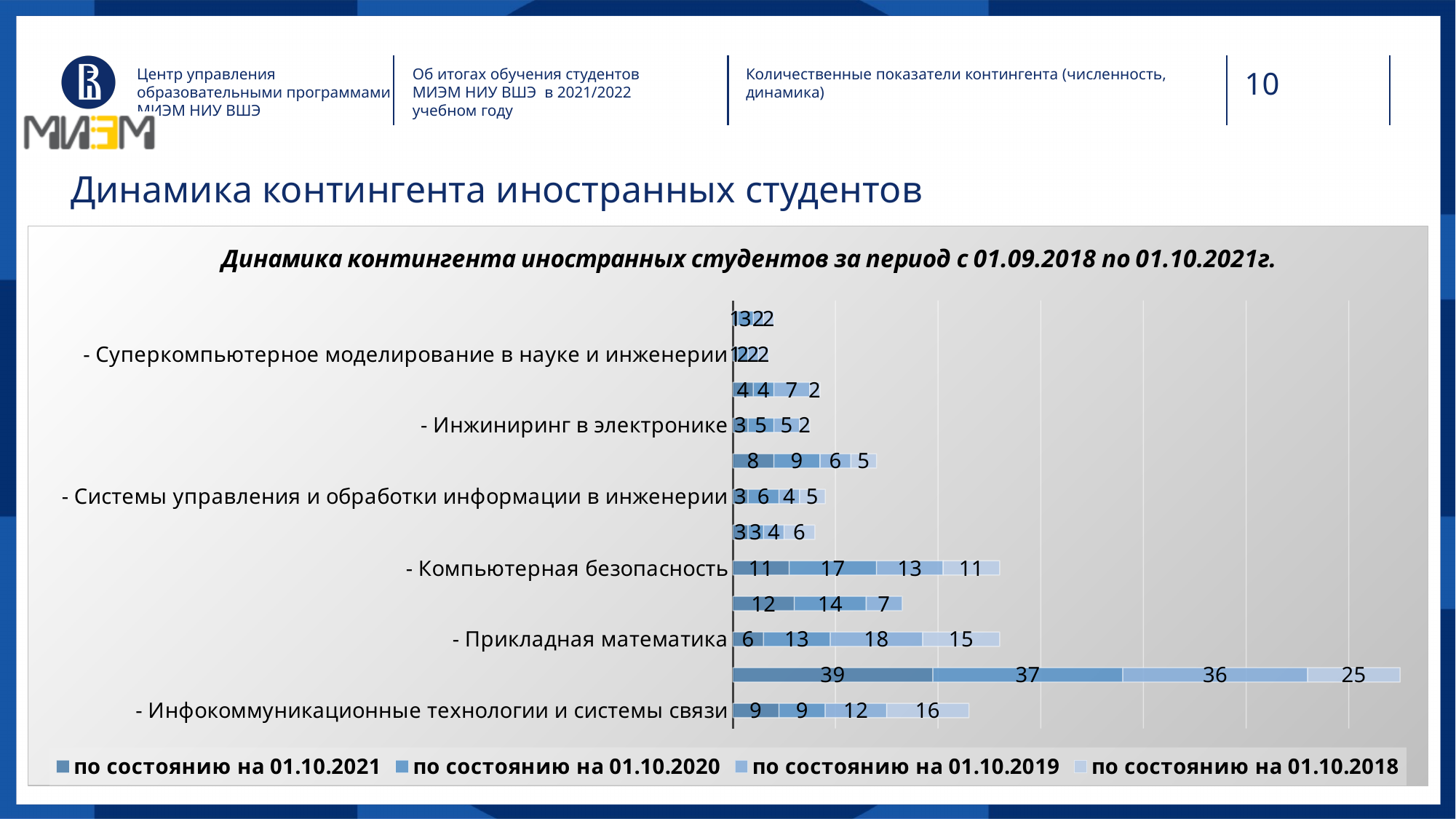
Did the value for Инфокоммуникационные технологии и системы связи rise or fall from 01.10.2018 to 01.10.2021? Fall How many series does the legend list? 4 Which has the larger value in the series 'по состоянию на 01.10.2020': Компьютерная безопасность or Прикладная математика? Компьютерная безопасность What is the value for Компьютерная безопасность in the series 'по состоянию на 01.10.2020'? 17 What kind of chart is shown on the slide? Stacked bar chart What is the title of the chart? Динамика контингента иностранных студентов за период с 01.09.2018 по 01.10.2021г. What is the value for Инжиниринг в электронике in the series 'по состоянию на 01.10.2018'? 2 What is the value for Инфокоммуникационные технологии и системы связи in the series 'по состоянию на 01.10.2018'? 16 What is the total of the stacked bar for Прикладная математика? 52 What is the total of the stacked bar for Инфокоммуникационные технологии и системы связи? 46 What is the value for Прикладная математика in the series 'по состоянию на 01.10.2019'? 18 What is the difference between the 01.10.2019 value and the 01.10.2021 value for Прикладная математика? 12